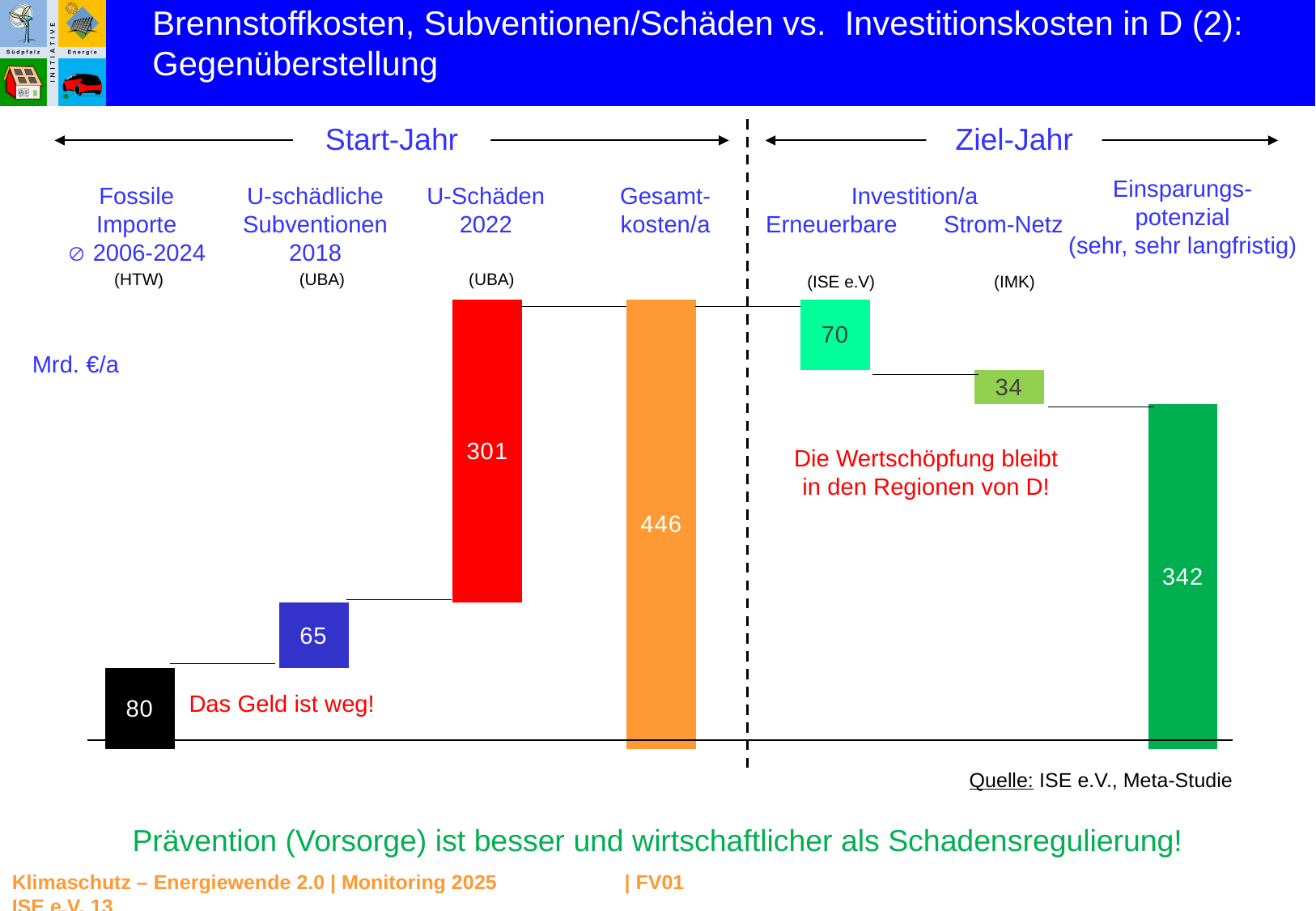
What unit is given for the values in the chart? Mrd. €/a Which is larger, U-Schäden 2022 or Einsparungspotenzial? Einsparungspotenzial What is the value shown for Einsparungspotenzial? 342 What is the value shown for Gesamtkosten/a? 446 What is the value shown for Fossile Importe (2006-2024)? 80 What is the value shown for U-Schäden 2022? 301 Which category has the highest value in the chart? Gesamtkosten/a What is the difference between Gesamtkosten/a and Einsparungspotenzial? 104 What is the value shown for Investition/a Erneuerbare? 70 Which category has the lowest value in the chart? Strom-Netz What is the value shown for U-schädliche Subventionen 2018? 65 What kind of chart is shown on the slide? Bar chart